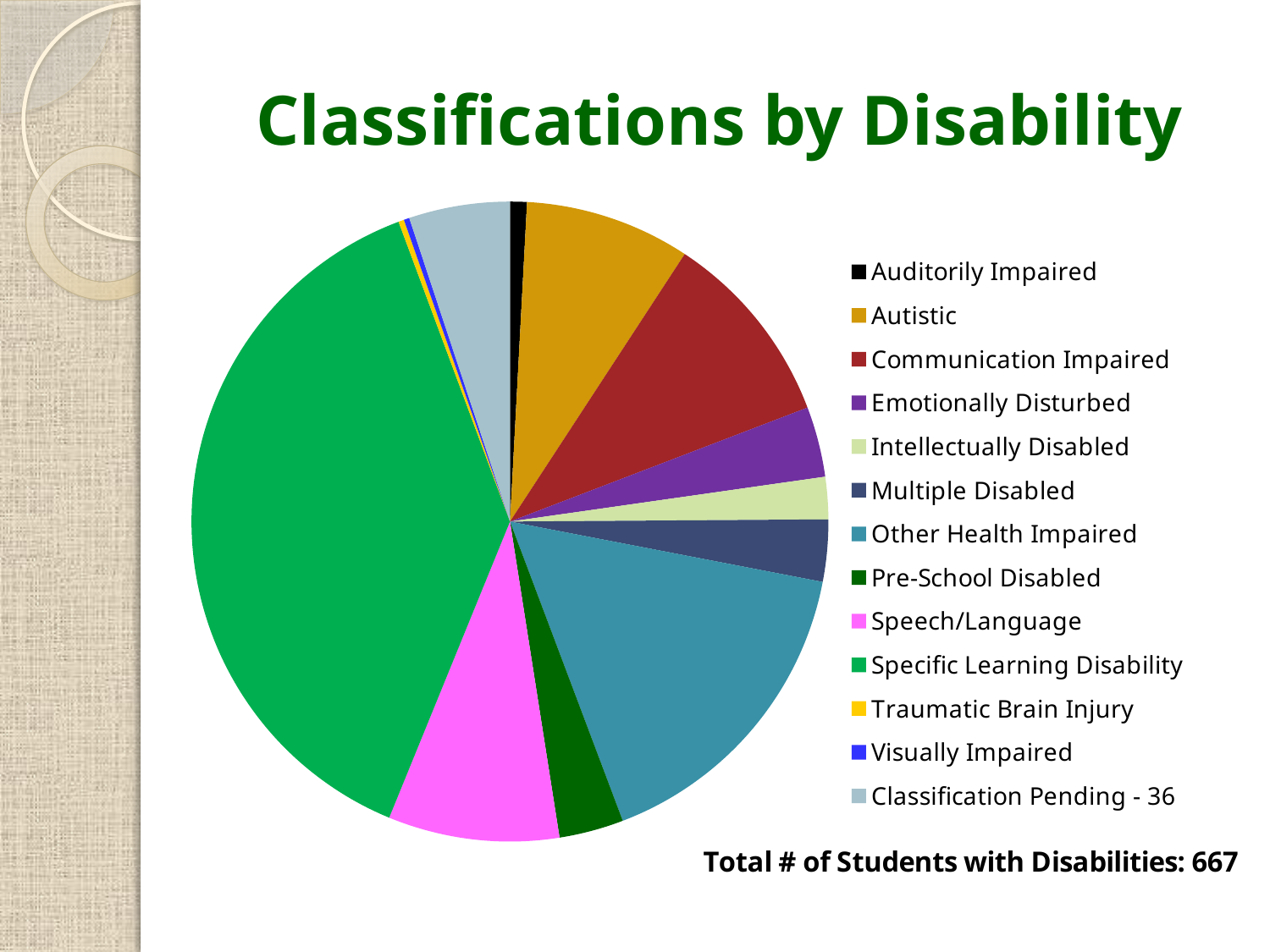
What is the title of the chart? Classifications by Disability Which is larger, the slice for Specific Learning Disability or the slice for Other Health Impaired? Specific Learning Disability What kind of chart is shown on the slide? pie chart What is the total number of students with disabilities stated on the slide? 667 How many disability categories does the legend list? 13 Which is larger, the slice for Other Health Impaired or the slice for Multiple Disabled? Other Health Impaired Which category has the largest slice of the pie? Specific Learning Disability Which category is shown in pink on the pie chart? Speech/Language What number is given for Classification Pending in the legend? 36 Which is larger, the slice for Autistic or the slice for Auditorily Impaired? Autistic